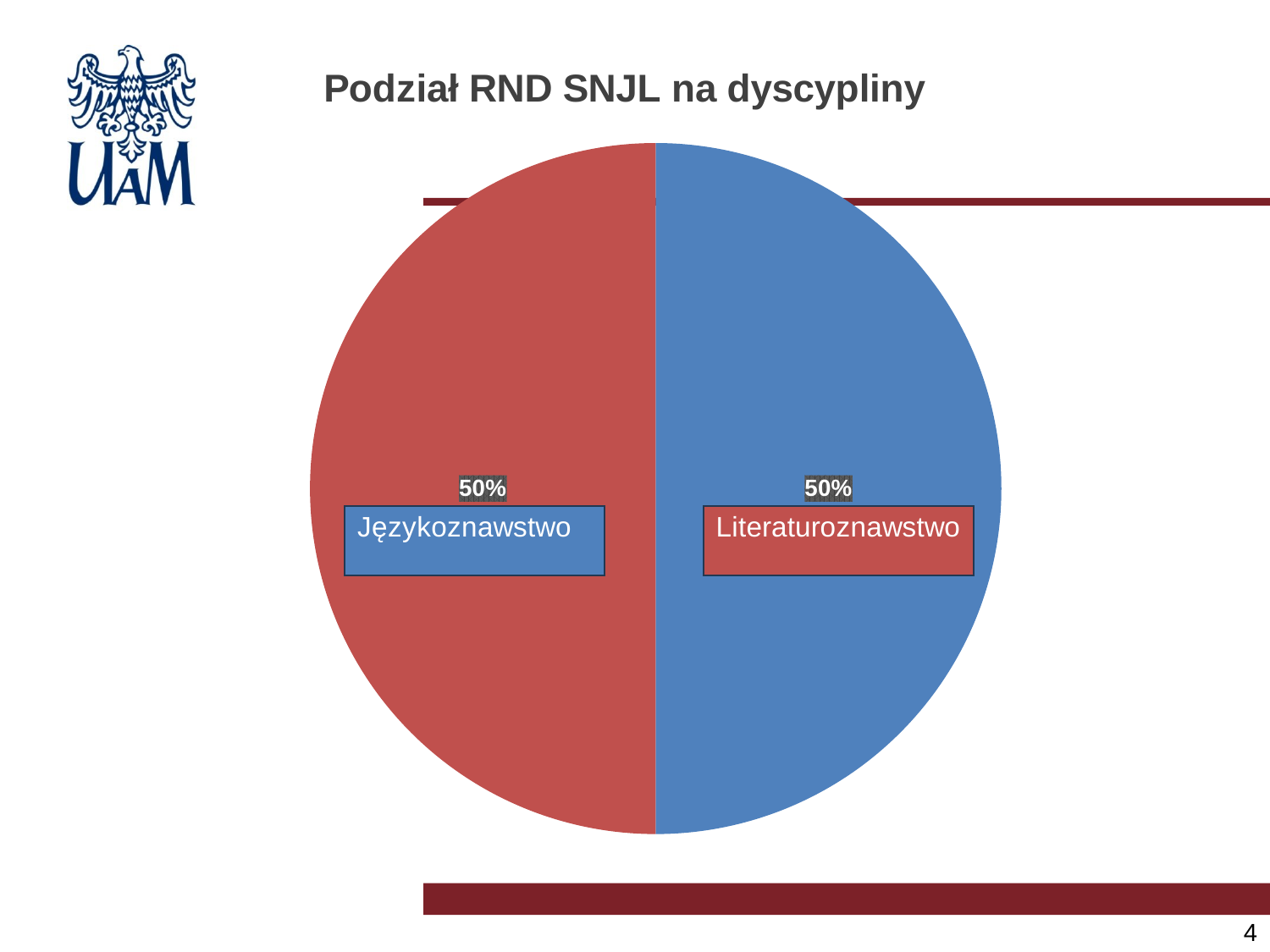
What is the value shown for the Językoznawstwo slice? 50% What is the title of the chart? Podział RND SNJL na dyscypliny What is the combined share of the Językoznawstwo and Literaturoznawstwo slices? 100% What is the value shown for the Literaturoznawstwo slice? 50% Which two disciplines are labelled on the pie chart? Językoznawstwo and Literaturoznawstwo What share of the pie does Językoznawstwo represent? 50% What kind of chart is shown on the slide? pie chart What share of the pie does Literaturoznawstwo represent? 50% Is the share for Literaturoznawstwo greater than, less than, or equal to the share for Językoznawstwo? equal How many slices does the pie chart have? 2